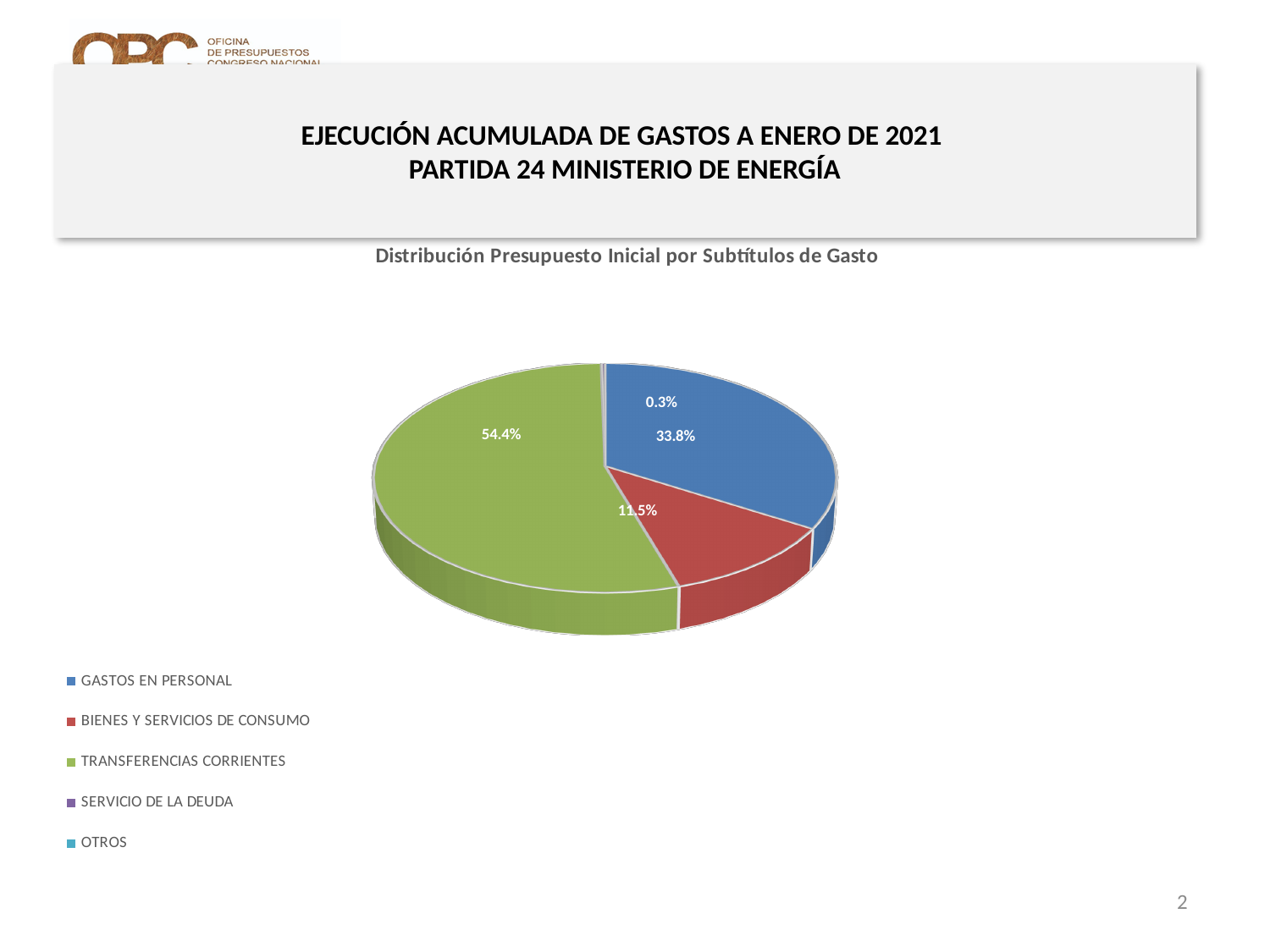
What percentage of the pie does BIENES Y SERVICIOS DE CONSUMO represent? 11.5% What percentage of the pie does TRANSFERENCIAS CORRIENTES represent? 54.4% How many categories does the legend list? 5 Is the share for TRANSFERENCIAS CORRIENTES greater or less than 50%? greater What is the title of the chart? Distribución Presupuesto Inicial por Subtítulos de Gasto What is the difference in percentage points between TRANSFERENCIAS CORRIENTES and GASTOS EN PERSONAL? 20.6 percentage points What kind of chart is shown on the slide? Pie chart What percentage of the pie does GASTOS EN PERSONAL represent? 33.8% Which category has the largest share of the pie? TRANSFERENCIAS CORRIENTES What colour is the TRANSFERENCIAS CORRIENTES slice? Green What is the difference in percentage points between GASTOS EN PERSONAL and BIENES Y SERVICIOS DE CONSUMO? 22.3 percentage points Which is larger, the share for GASTOS EN PERSONAL or the share for BIENES Y SERVICIOS DE CONSUMO? GASTOS EN PERSONAL